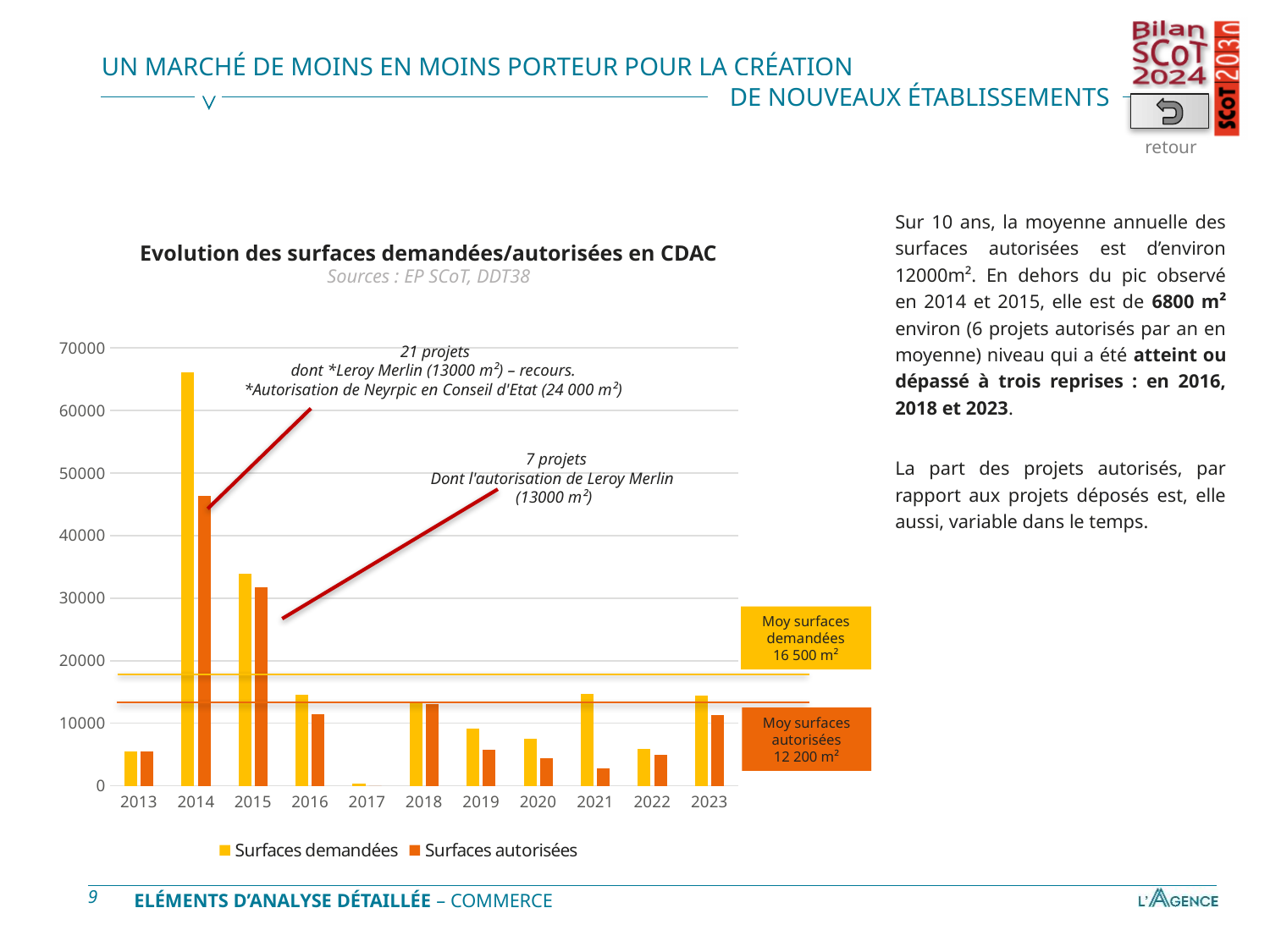
Is the value for Surfaces demandées in 2015 greater or less than 30000? greater Is the value for Surfaces demandées in 2014 greater or less than 60000? greater Which is larger in 2016: Surfaces demandées or Surfaces autorisées? Surfaces demandées What average value is given in the box labelled 'Moy surfaces autorisées'? 12 200 m² In which year is the value for Surfaces demandées the lowest? 2017 Is the value for Surfaces autorisées in 2021 greater or less than 10000? less What is the title of the chart? Evolution des surfaces demandées/autorisées en CDAC How many series does the chart legend list? 2 How many years are shown on the x axis of the chart? 11 Do the values for Surfaces demandées rise or fall from 2014 to 2017? fall What kind of chart is shown on the slide? bar chart In which year is the value for Surfaces demandées the highest? 2014